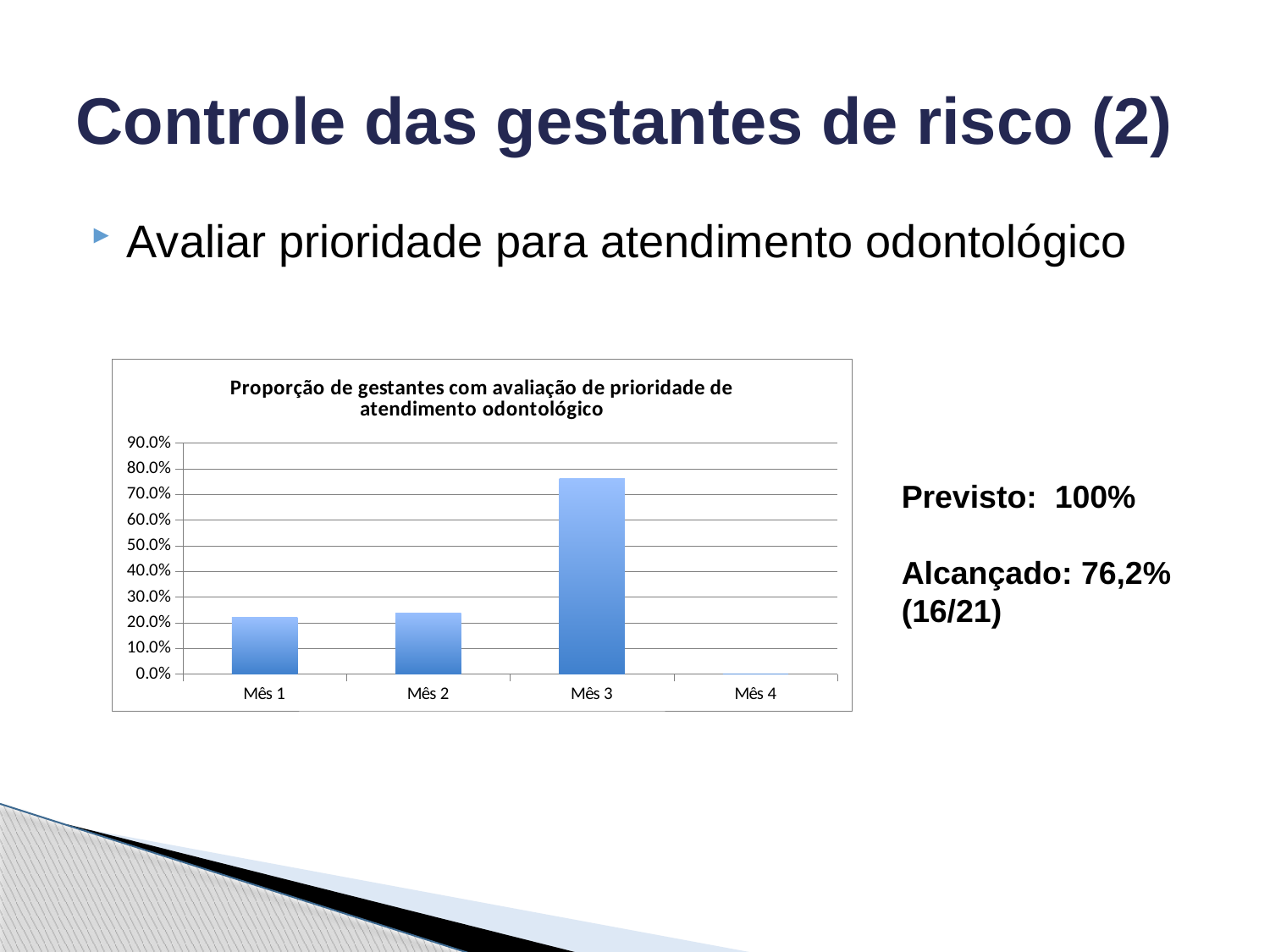
Which month has the highest value in the chart? Mês 3 Is the value for Mês 1 greater or less than 30.0%? less What kind of chart is shown on the slide? bar chart Is the value for Mês 3 greater or less than 70.0%? greater Which month has the lowest value in the chart? Mês 4 Which is larger, the value for Mês 3 or the value for Mês 1? Mês 3 What is the title of the chart? Proporção de gestantes com avaliação de prioridade de atendimento odontológico How many categories are shown on the x axis of the chart? 4 Is the value for Mês 2 greater or less than 20.0%? greater Do the values rise or fall from Mês 1 to Mês 3? rise What is the highest value shown on the chart's y axis? 90.0%